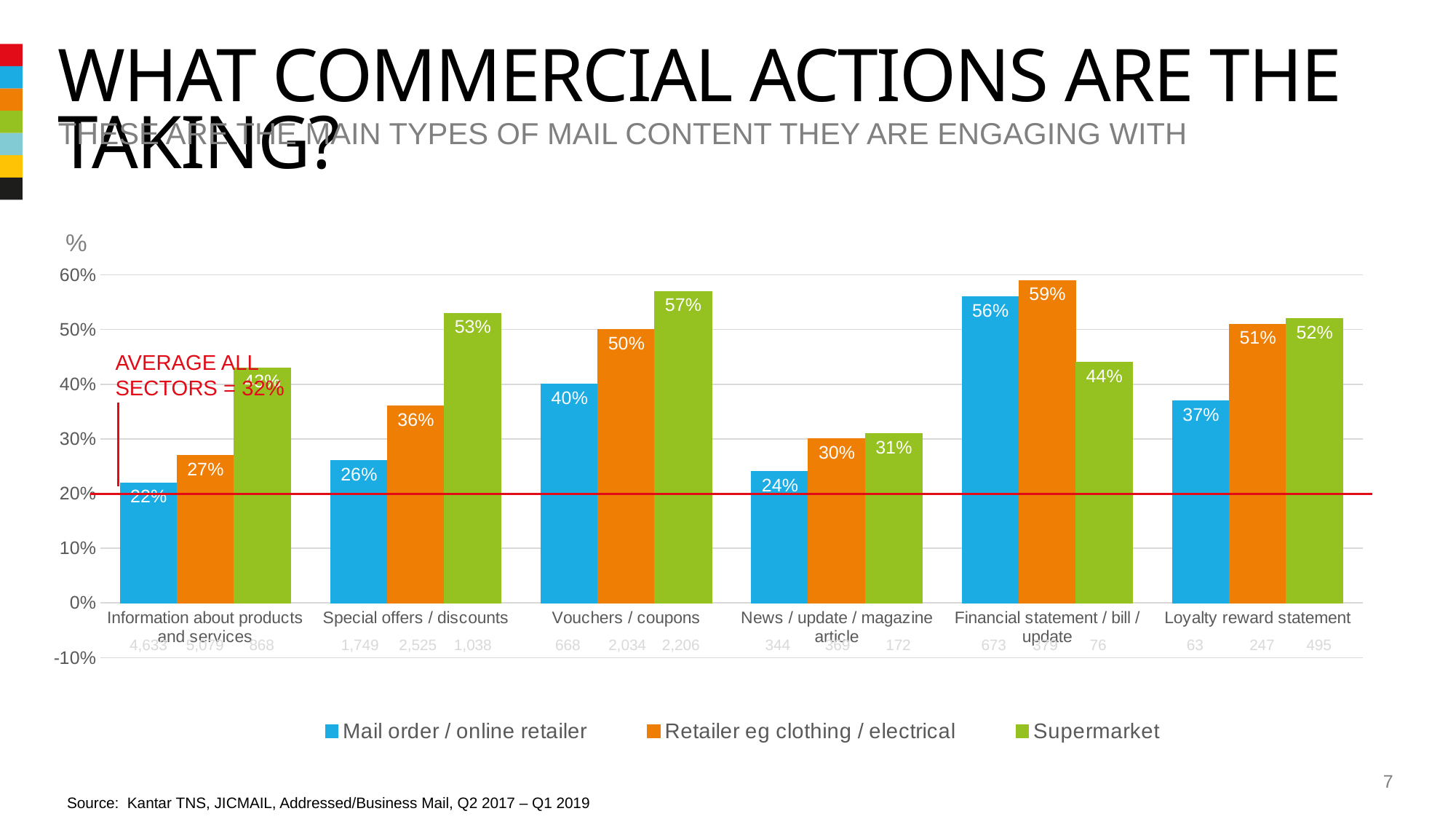
What is the difference between the Supermarket and Mail order / online retailer values in the Special offers / discounts category? 27% Is the value for Mail order / online retailer in the News / update / magazine article category greater or less than 30%? less What average across all sectors is stated in the red annotation on the chart? 32% Which category has the lowest value for Mail order / online retailer? Information about products and services What kind of chart is shown on the slide? bar chart How many series does the legend list? 3 Which category has the highest value for Retailer eg clothing / electrical? Financial statement / bill / update How many mail content categories are shown on the x axis? 6 What is the value for Mail order / online retailer in the Financial statement / bill / update category? 56% In the Financial statement / bill / update category, which is larger: the Retailer eg clothing / electrical value or the Supermarket value? Retailer eg clothing / electrical What is the value for Retailer eg clothing / electrical in the Special offers / discounts category? 36% What is the value for Supermarket in the Vouchers / coupons category? 57%